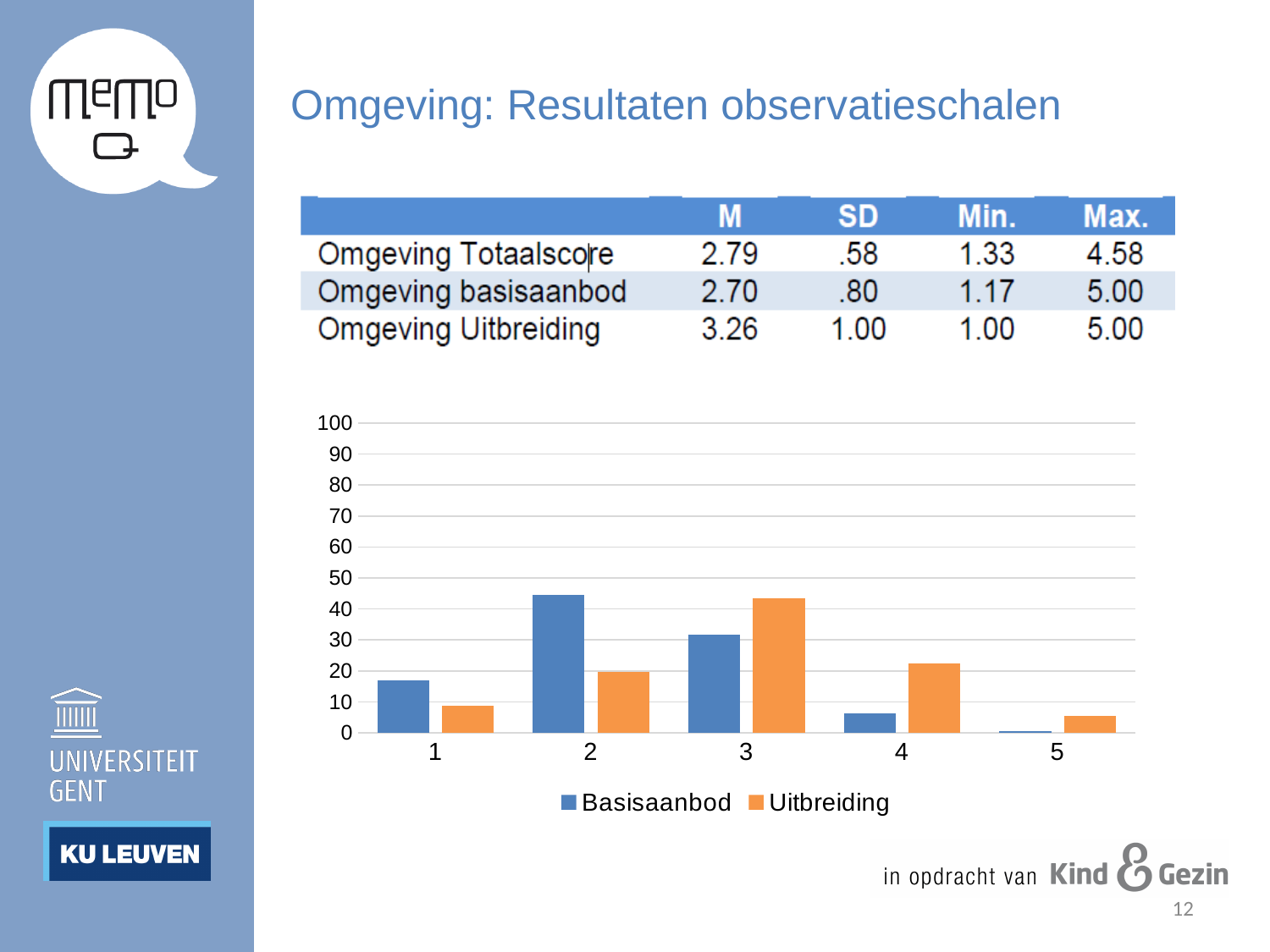
For which category is the Basisaanbod bar lowest? 5 At category 1, which series has the larger value, Basisaanbod or Uitbreiding? Basisaanbod How many series does the legend of the bar chart list? 2 Is the Uitbreiding value for category 1 greater or less than 10? less What kind of chart is shown on the slide? bar chart Is the Basisaanbod value for category 2 greater or less than 40? greater For which category is the Uitbreiding bar highest? 3 At category 4, which series has the larger value, Basisaanbod or Uitbreiding? Uitbreiding For which category is the Uitbreiding bar lowest? 5 How many categories are shown on the x axis of the bar chart? 5 For which category is the Basisaanbod bar highest? 2 Which series are listed in the legend of the bar chart? Basisaanbod and Uitbreiding